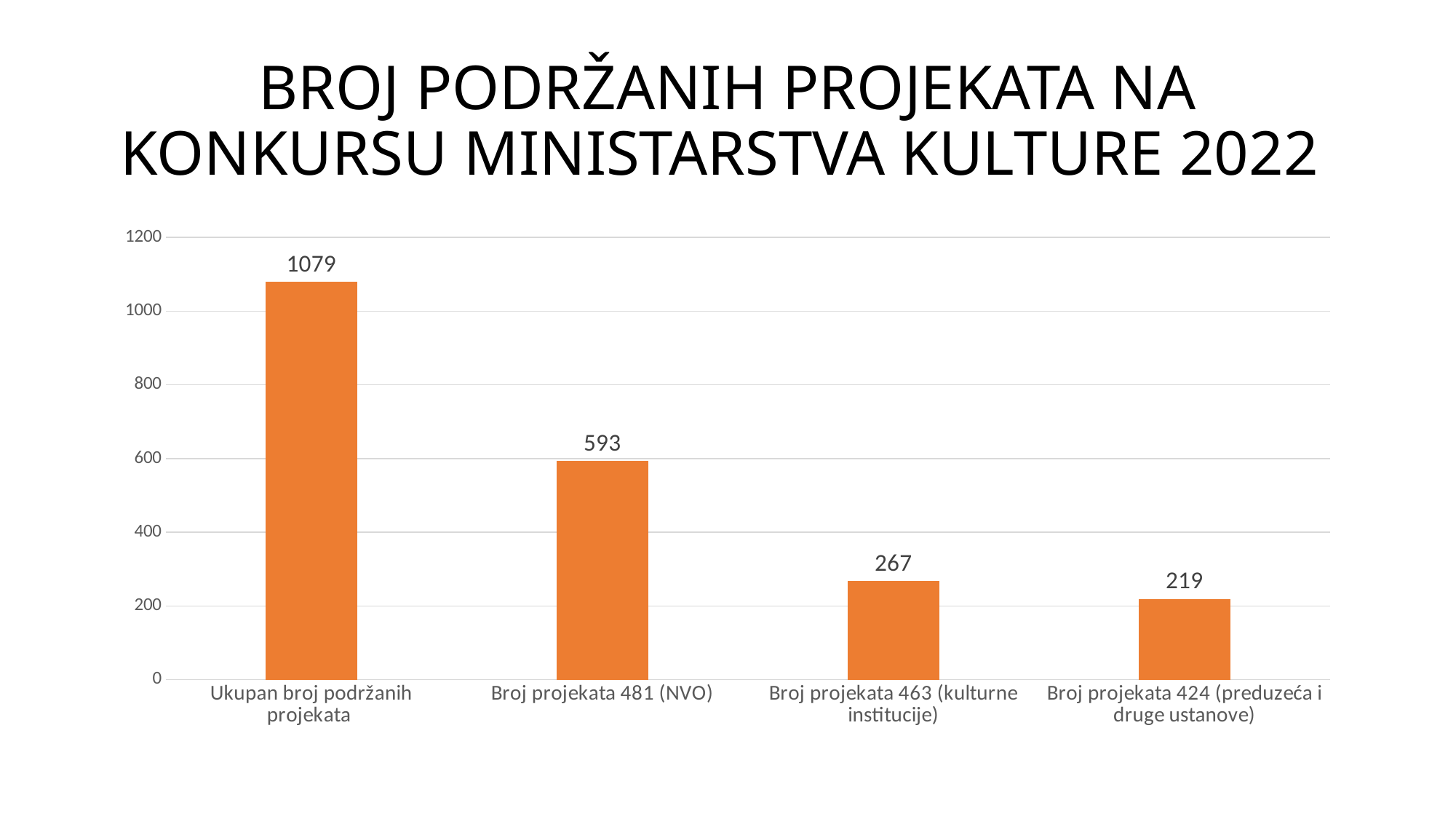
What is the value for "Broj projekata 463 (kulturne institucije)"? 267 Which is larger, the value for "Broj projekata 463 (kulturne institucije)" or "Broj projekata 424 (preduzeća i druge ustanove)"? Broj projekata 463 (kulturne institucije) What is the value for "Broj projekata 481 (NVO)"? 593 What is the title of the chart? BROJ PODRŽANIH PROJEKATA NA KONKURSU MINISTARSTVA KULTURE 2022 What is the difference between the values for "Broj projekata 481 (NVO)" and "Broj projekata 463 (kulturne institucije)"? 326 What is the value for "Broj projekata 424 (preduzeća i druge ustanove)"? 219 What kind of chart is shown on the slide? Bar chart Which category has the highest value? Ukupan broj podržanih projekata Which category has the lowest value? Broj projekata 424 (preduzeća i druge ustanove) How many categories are shown on the chart? 4 What is the value for "Ukupan broj podržanih projekata"? 1079 Is the value for "Broj projekata 481 (NVO)" greater or less than 400? greater